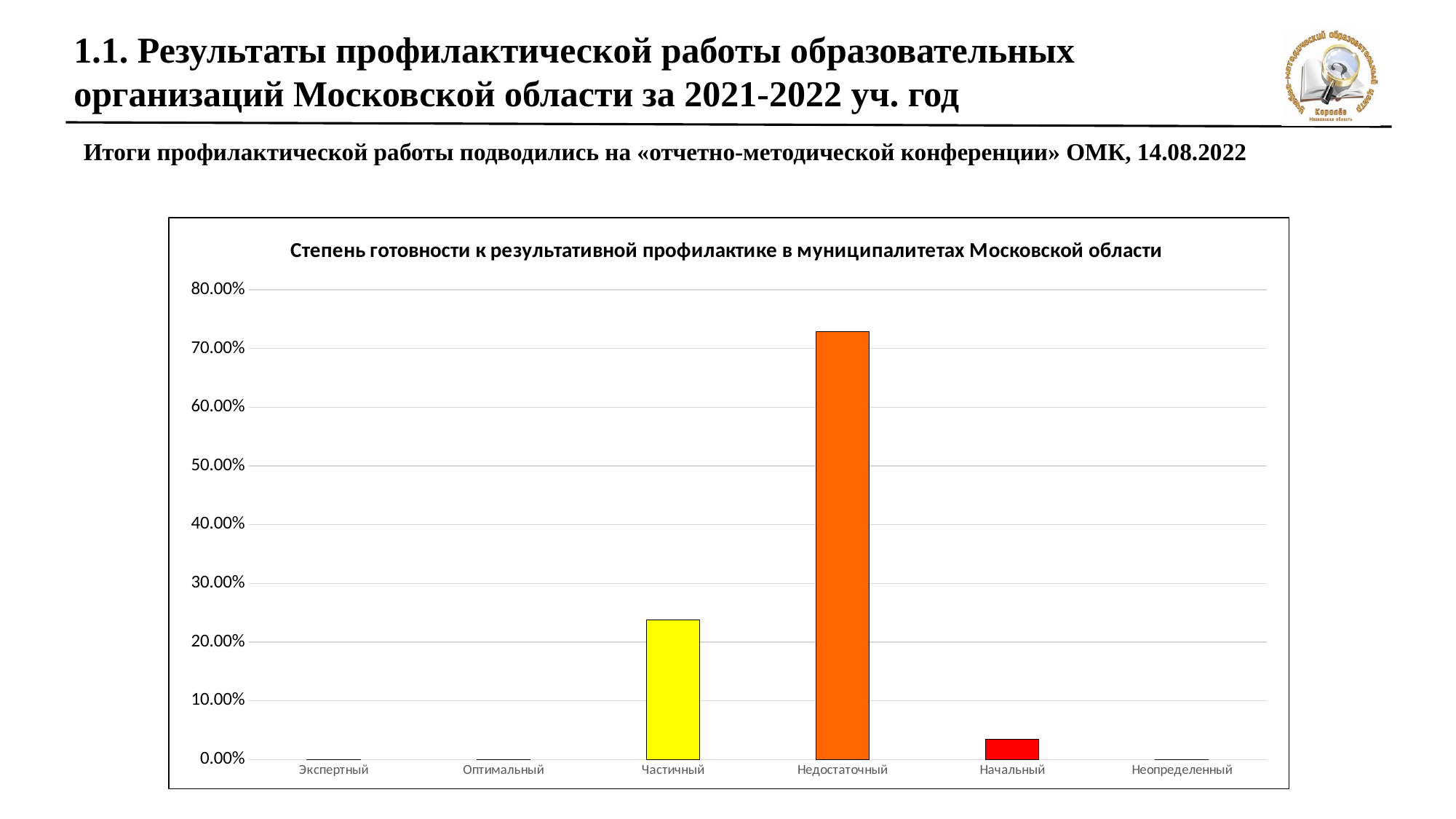
Which is larger, the value for Недостаточный or the value for Частичный? Недостаточный Is the value for Начальный greater or less than 10.00%? less How many categories are shown on the x axis of the chart? 6 What is the title of the chart? Степень готовности к результативной профилактике в муниципалитетах Московской области What kind of chart is shown on the slide? bar chart What colour is the bar for Частичный? yellow Is the value for Частичный greater or less than 30.00%? less Is the value for Недостаточный greater or less than 70.00%? greater Which is larger, the value for Частичный or the value for Начальный? Частичный Which category has the highest value in the chart? Недостаточный